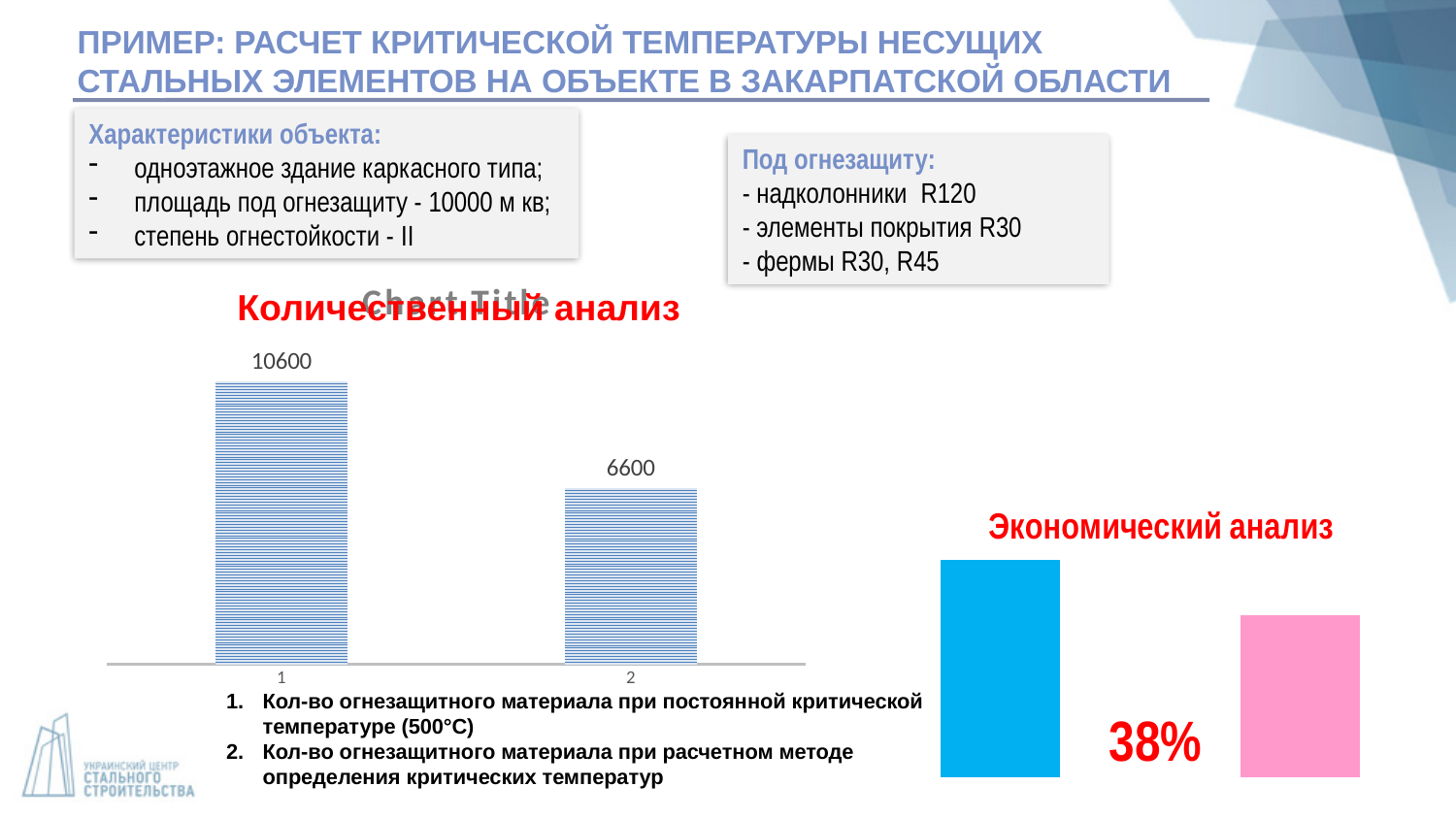
How many bars are plotted on the 'Количественный анализ' chart? 2 On the 'Экономический анализ' chart, which bar is taller: the blue bar on the left or the pink bar on the right? The blue bar on the left How many bars are shown on the 'Экономический анализ' chart? 2 What percentage is printed next to the 'Экономический анализ' chart? 38% On the 'Количественный анализ' chart, do the values rise or fall from category 1 to category 2? Fall On the 'Количественный анализ' chart, what is the value for category 2? 6600 On the 'Количественный анализ' chart, what is the difference between the values for category 1 and category 2? 4000 What kind of chart is the 'Количественный анализ' chart? Bar chart On the 'Количественный анализ' chart, which category has the lowest value? 2 On the 'Количественный анализ' chart, what is the value for category 1? 10600 On the 'Количественный анализ' chart, which is larger: the value for category 1 or category 2? Category 1 On the 'Количественный анализ' chart, which category has the highest value? 1